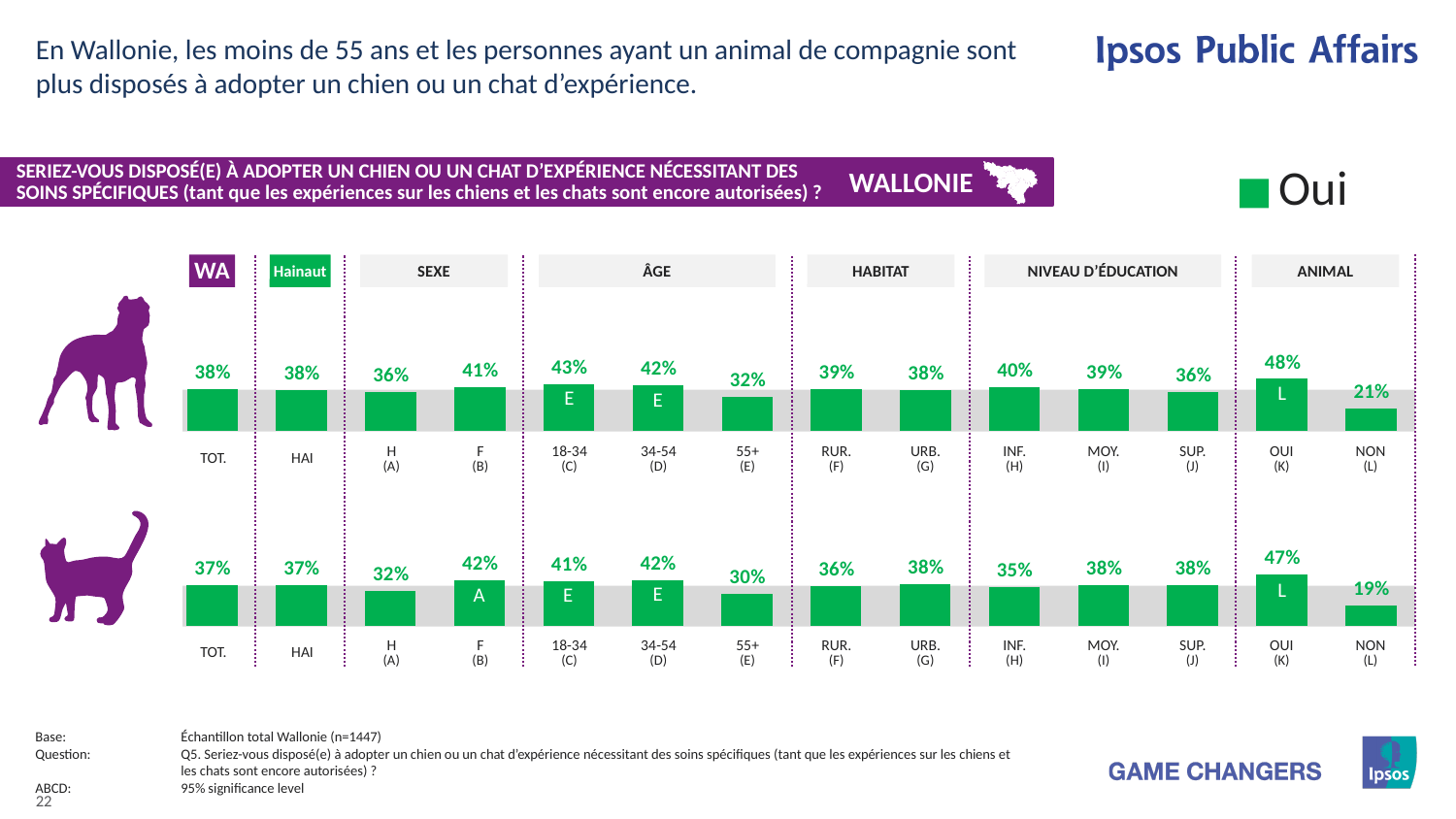
In the bottom (cat) chart, which category has the lowest value? NON (L) In the bottom (cat) chart, which is larger, the value for H (A) or F (B)? F (B) In the top (dog) chart, which category has the highest value? OUI (K) In the bottom (cat) chart, what is the value for the 55+ age group? 30% How many series does the legend list? 1 In the bottom (cat) chart, what is the difference between the values for RUR. (F) and URB. (G)? 2% In the top (dog) chart, what is the difference between the values for OUI (K) and NON (L)? 27% What is the legend entry shown on the slide? Oui In the top (dog) chart, do the values rise or fall across the age groups from 18-34 to 55+? fall In the top (dog) chart, what is the value for the 18-34 age group? 43% What kind of chart is used on the slide? bar chart In the top (dog) chart, what is the value for TOT.? 38%